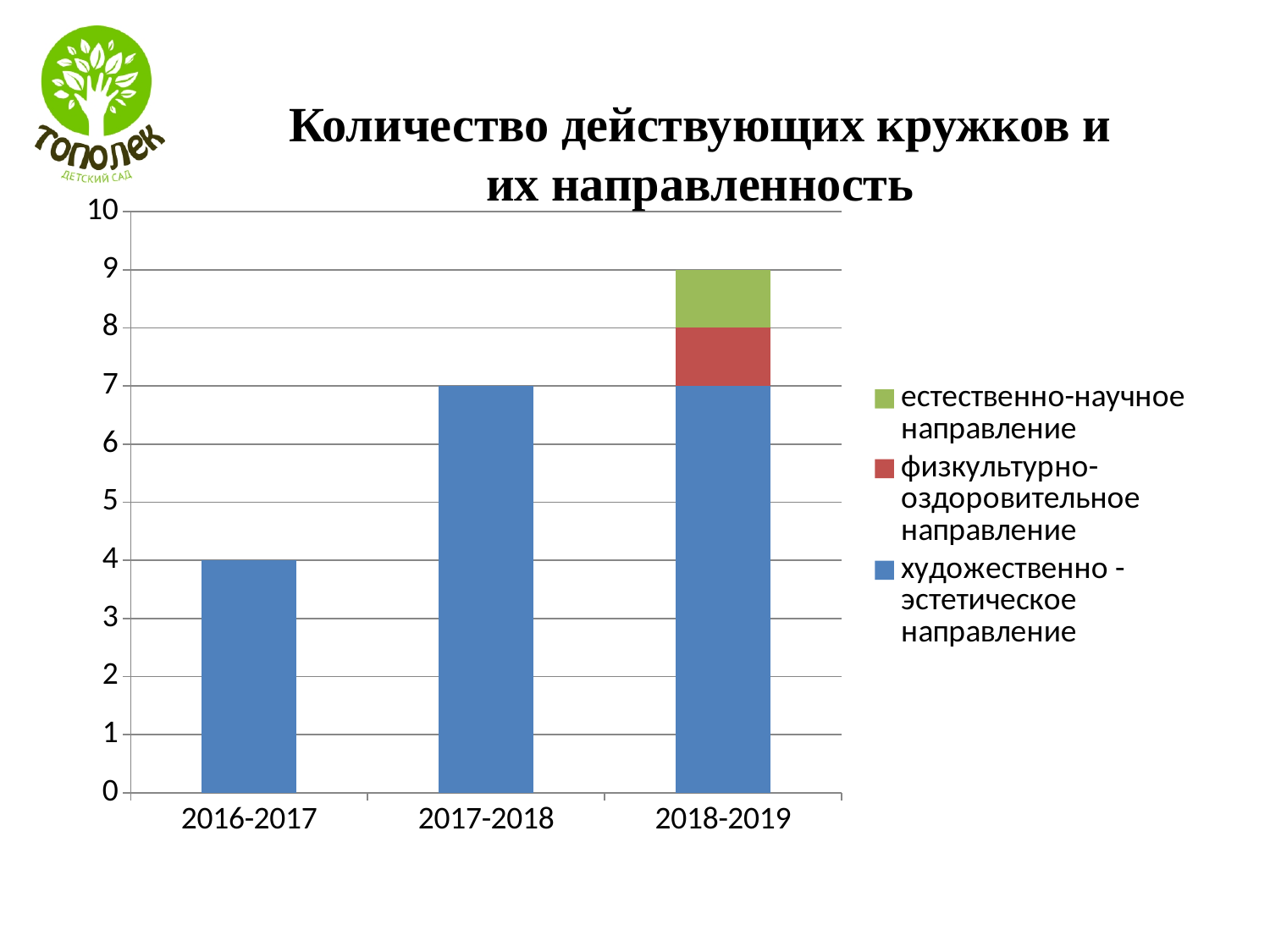
How many categories are shown on the x axis? 3 What kind of chart is shown on the slide? Stacked bar chart Which year has the highest total number of кружки? 2018-2019 What is the total height of the stacked bar for 2018-2019? 9 Do the total values rise or fall from 2016-2017 to 2018-2019? Rise What is the title of the chart? Количество действующих кружков и их направленность What is the value for художественно-эстетическое направление in 2017-2018? 7 How many series does the legend list? 3 What is the difference between the total for 2018-2019 and the total for 2016-2017? 5 What is the value for физкультурно-оздоровительное направление in 2018-2019? 1 What is the value for художественно-эстетическое направление in 2016-2017? 4 Which year has the lowest total number of кружки? 2016-2017